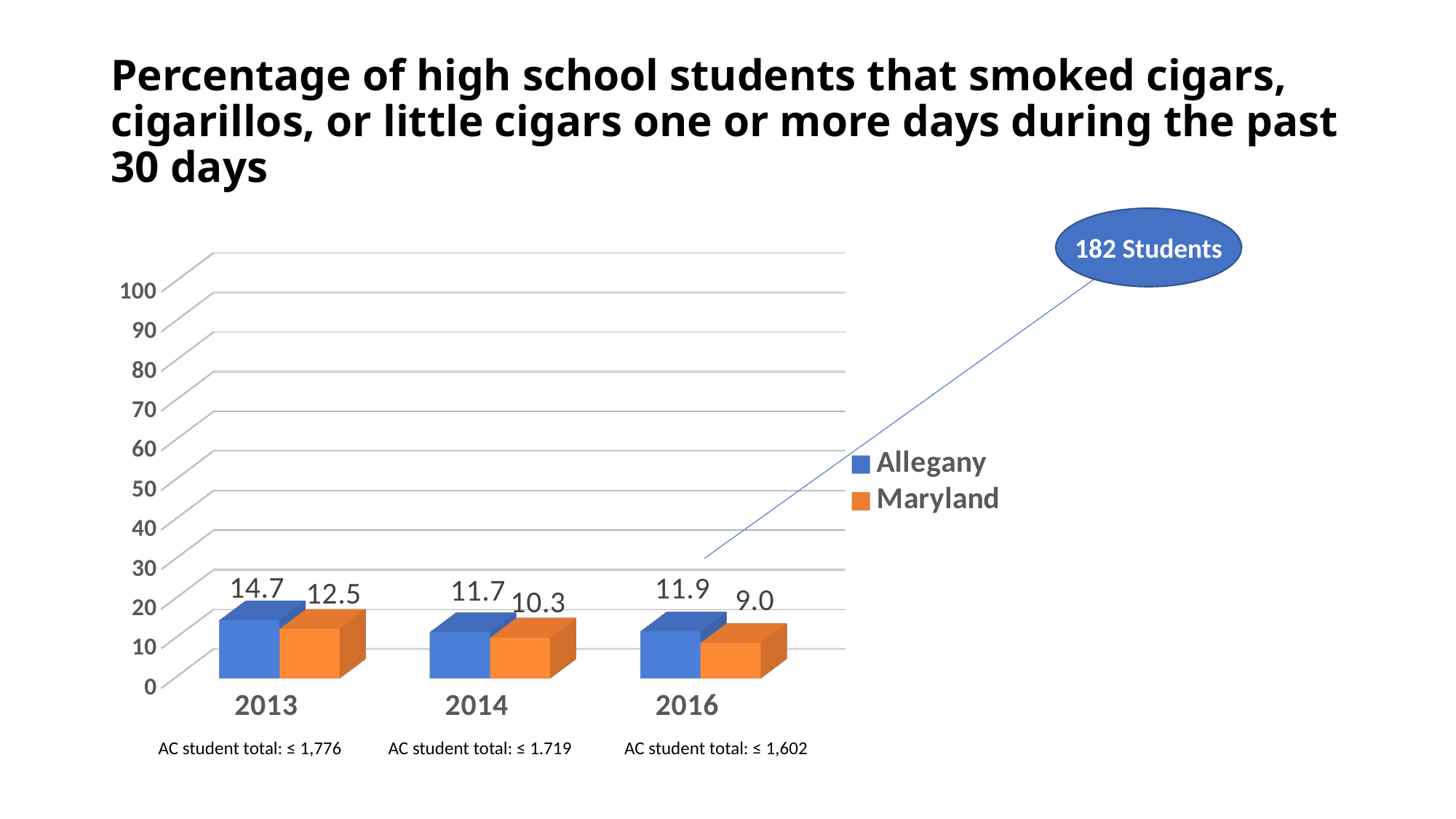
What is the value for Maryland in 2016? 9.0 Which is larger in 2014, the Allegany value or the Maryland value? Allegany What is the difference between the Allegany and Maryland values in 2013? 2.2 How many series does the legend list? 2 What is the difference between the Allegany and Maryland values in 2016? 2.9 What is the value for Maryland in 2014? 10.3 In which year is the Allegany value highest? 2013 Is the value for Allegany in 2013 greater or less than 20? less How many years are shown on the x axis? 3 In which year is the Maryland value lowest? 2016 What kind of chart is shown on the slide? bar chart What is the value for Allegany in 2013? 14.7